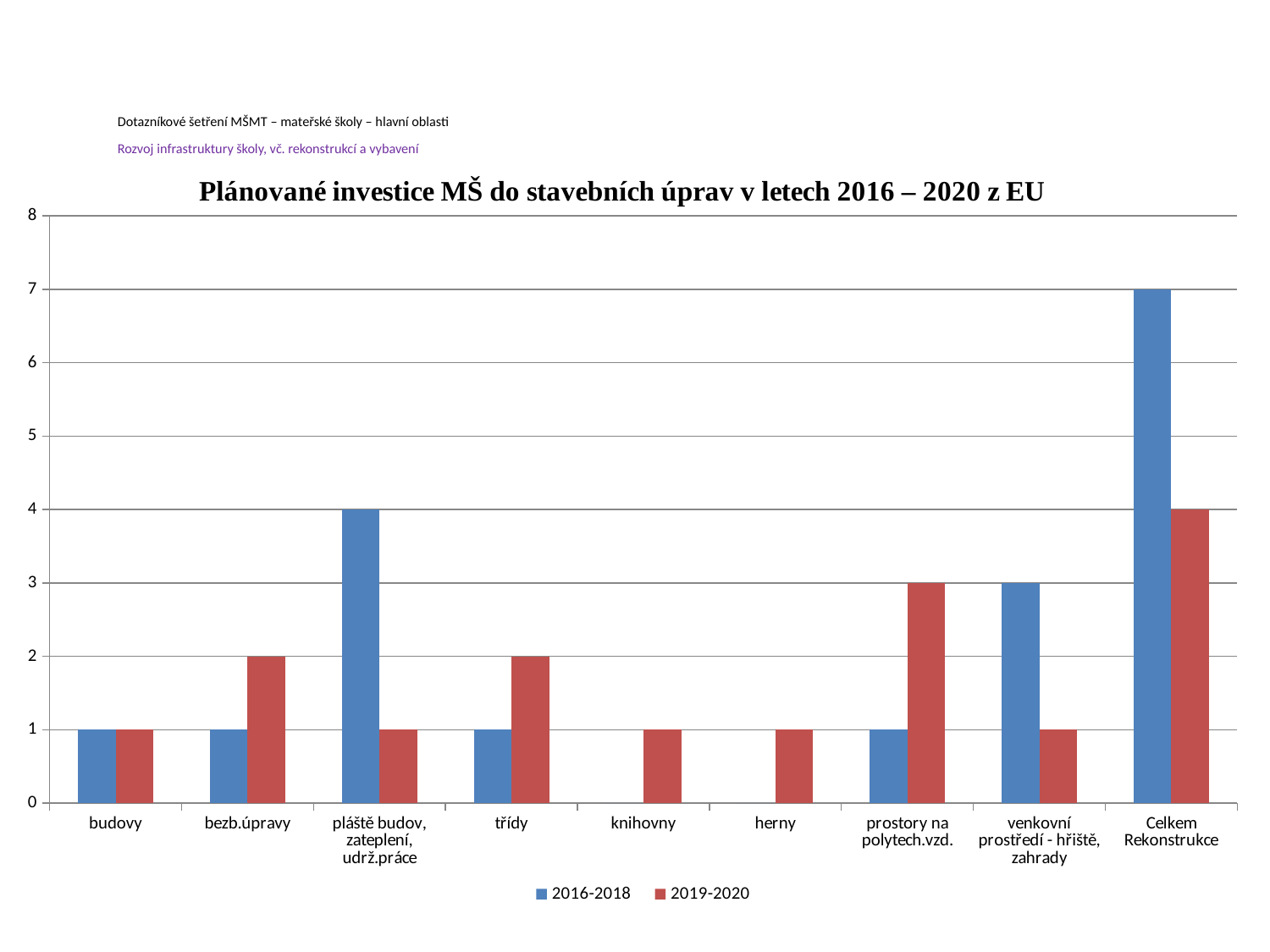
How many categories are shown on the x axis? 9 What is the difference between the 2016-2018 and 2019-2020 values for 'Celkem Rekonstrukce'? 3 What is the value for 'Celkem Rekonstrukce' in the 2016-2018 series? 7 For 'venkovní prostředí - hřiště, zahrady', which series has the larger value, 2016-2018 or 2019-2020? 2016-2018 What type of chart is shown on the slide? bar chart How many series does the legend list? 2 What is the value for 'pláště budov, zateplení, udrž.práce' in the 2016-2018 series? 4 Which category has the highest value in the 2019-2020 series? Celkem Rekonstrukce Is the 2016-2018 value for 'Celkem Rekonstrukce' greater or less than 6? greater What is the value for 'prostory na polytech.vzd.' in the 2019-2020 series? 3 What is the value for 'třídy' in the 2019-2020 series? 2 What is the title of the chart? Plánované investice MŠ do stavebních úprav v letech 2016 – 2020 z EU